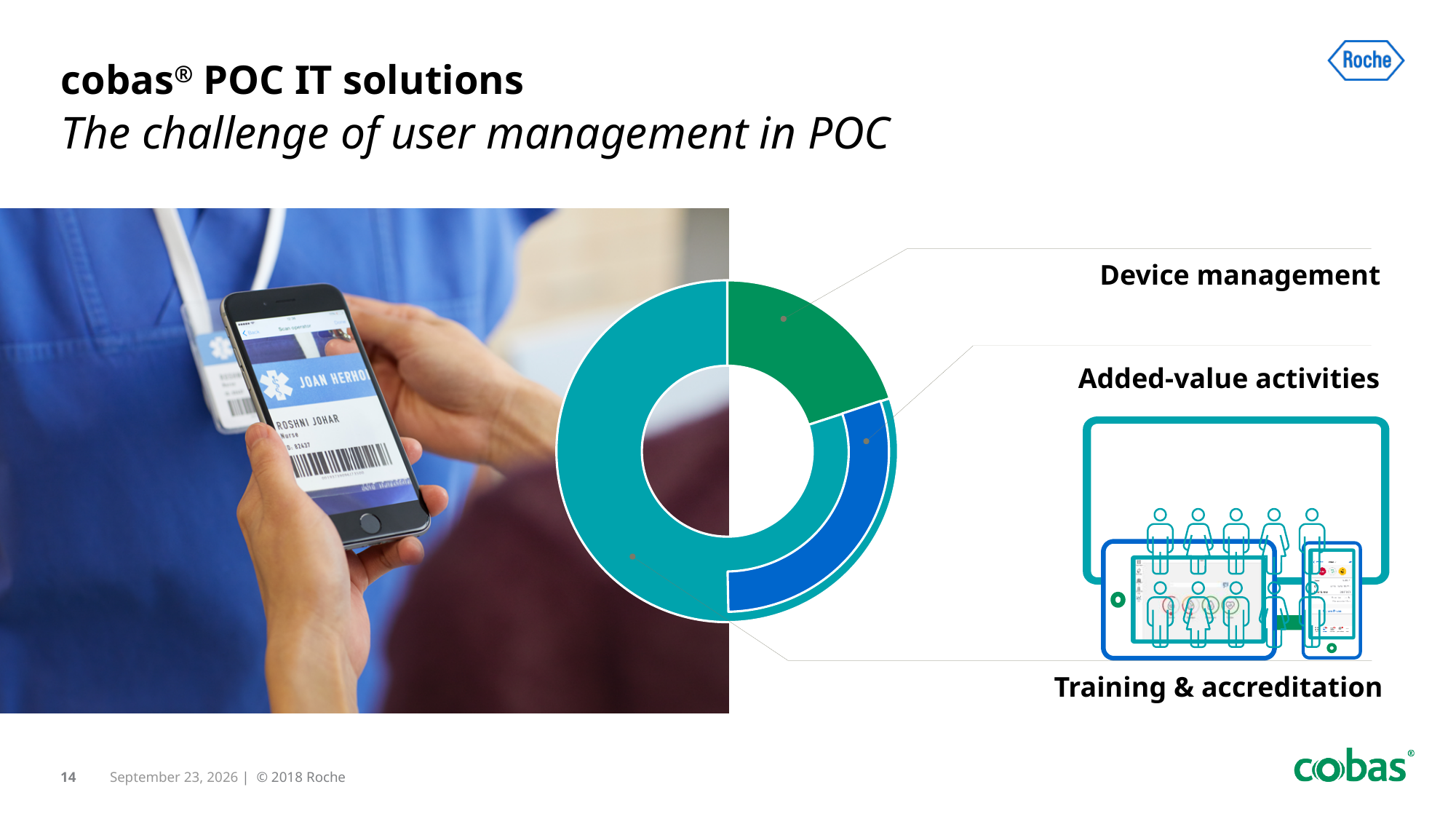
What kind of chart is shown on the slide? donut chart Which segment of the donut chart is coloured blue? Added-value activities What colour is the Device management segment of the donut chart? green How many segments does the donut chart have? 3 Which segment is larger, Training & accreditation or Device management? Training & accreditation Which segment is larger, Training & accreditation or Added-value activities? Training & accreditation Which segment of the donut chart is the largest? Training & accreditation